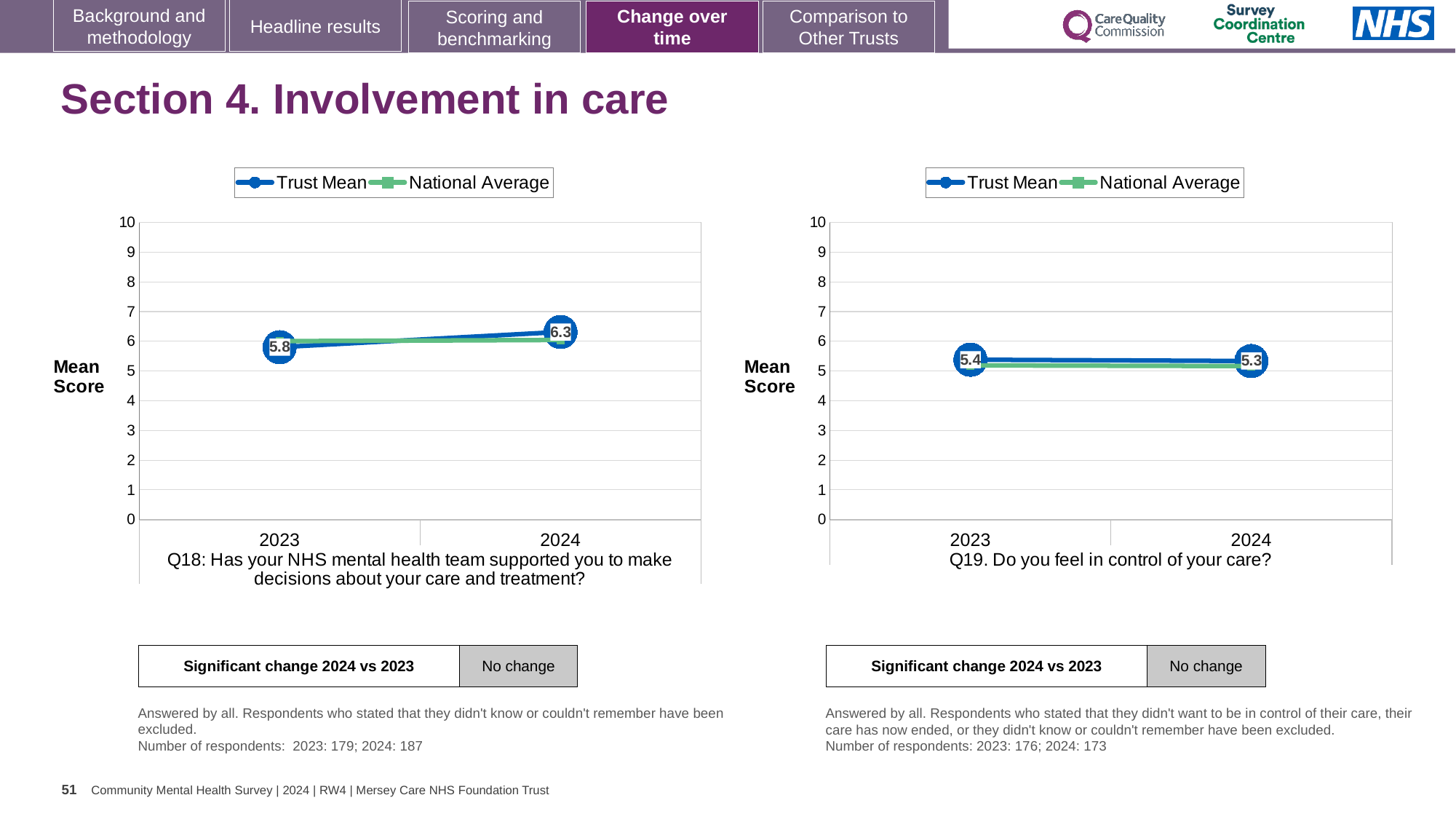
How many years are shown on the x axis of the Q19 chart? 2 How many series does the legend of the Q18 chart list? 2 In the Q18 chart, which year has the higher Trust Mean, 2023 or 2024? 2024 In the Q19 chart, what is the Trust Mean score for 2024? 5.3 In the Q18 chart, what is the Trust Mean score for 2023? 5.8 In the Q18 chart, by how much did the Trust Mean change from 2023 to 2024? 0.5 In the Q19 chart, does the Trust Mean rise or fall from 2023 to 2024? fall In the Q18 chart, what is the Trust Mean score for 2024? 6.3 In the Q18 chart, does the Trust Mean rise or fall from 2023 to 2024? rise What kind of chart is the Q19 chart? line chart In the Q19 chart, is the National Average value for 2024 greater or less than 5? greater In the Q19 chart, what is the Trust Mean score for 2023? 5.4